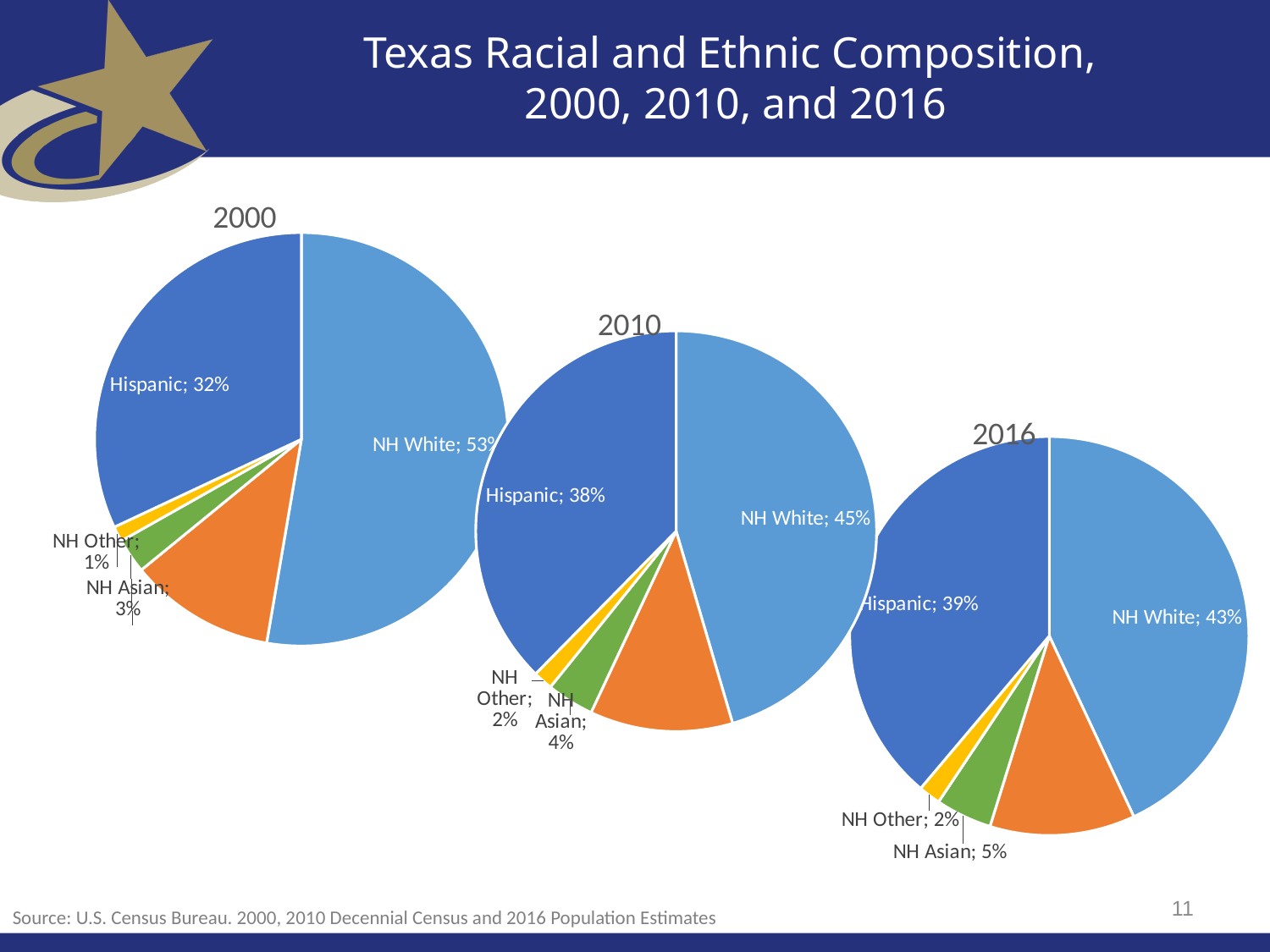
In the 2010 pie chart, what share is Hispanic? 38% What is the title of the slide? Texas Racial and Ethnic Composition, 2000, 2010, and 2016 How many slices does the 2010 pie chart have? 5 Across the 2000, 2010, and 2016 pie charts, does the Hispanic share rise or fall over time? Rise In the 2010 pie chart, which labeled category has the smallest share? NH Other What kind of charts are shown on the slide? Pie charts In the 2016 pie chart, which is larger, the NH White share or the Hispanic share? NH White In the 2000 pie chart, which labeled category has the largest share? NH White In the 2000 pie chart, what share is NH White? 53% What is the difference between the NH White share in 2000 and in 2016? 10 percentage points In the 2016 pie chart, what share is NH Other? 2% In the 2016 pie chart, what share is NH Asian? 5%